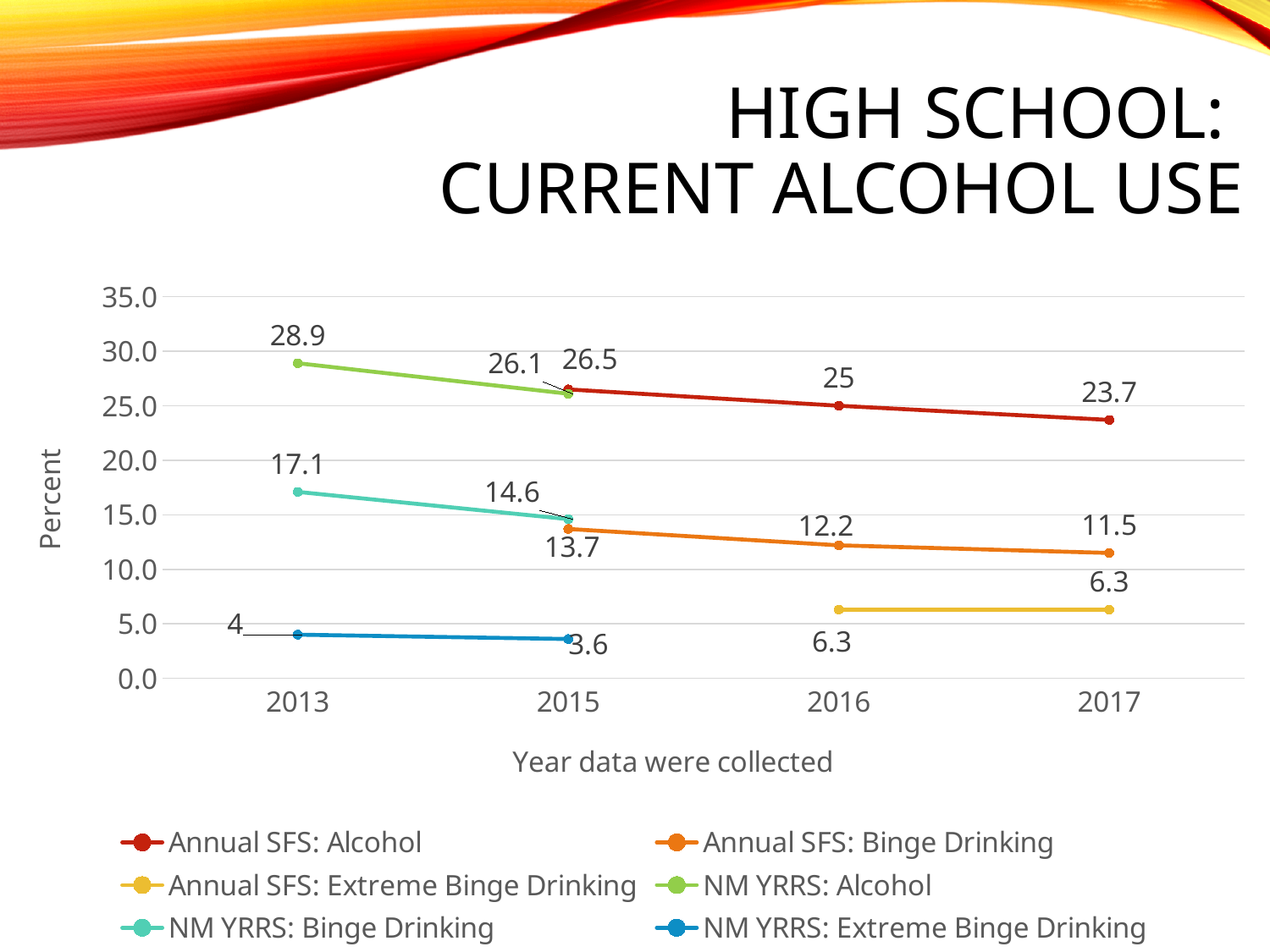
What is the value for NM YRRS: Extreme Binge Drinking in 2015? 3.6 What kind of chart is shown on the slide? line chart What is the value for Annual SFS: Extreme Binge Drinking in 2017? 6.3 Which series and year has the highest value on the chart? NM YRRS: Alcohol in 2013 Which is larger: NM YRRS: Binge Drinking in 2013 or Annual SFS: Binge Drinking in 2015? NM YRRS: Binge Drinking in 2013 What is the value for Annual SFS: Binge Drinking in 2016? 12.2 What is the value for NM YRRS: Alcohol in 2013? 28.9 How many series does the legend list? 6 What is the value for Annual SFS: Alcohol in 2017? 23.7 What is the difference between NM YRRS: Binge Drinking in 2013 and in 2015? 2.5 By how much did Annual SFS: Alcohol fall from 2015 to 2017? 2.8 Does Annual SFS: Alcohol rise or fall from 2015 to 2017? fall